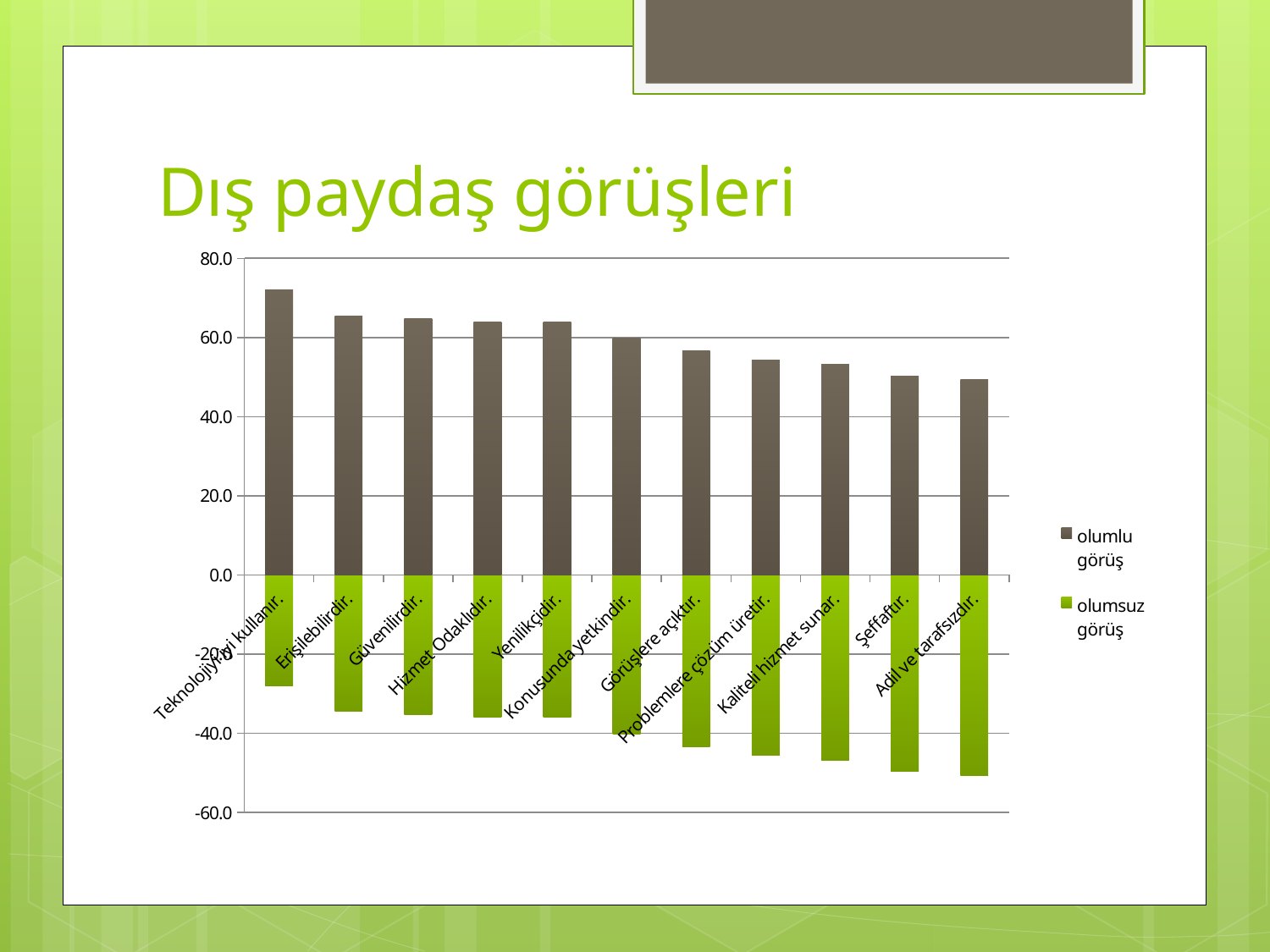
Is the olumsuz görüş value for Adil ve tarafsızdır greater or less than -40? less Is the olumlu görüş value for Adil ve tarafsızdır greater or less than 60? less What kind of chart is shown on the slide? Bar chart Which category has the lowest olumlu görüş value? Adil ve tarafsızdır. Is the olumlu görüş value for Teknolojiyi iyi kullanır greater or less than 60? greater Which category has the highest olumlu görüş value? Teknolojiyi iyi kullanır. How many series does the chart's legend list? 2 What is the title of the slide containing the chart? Dış paydaş görüşleri Which has the larger olumlu görüş value, Erişilebilirdir or Şeffaftır? Erişilebilirdir. Do the olumlu görüş values rise or fall from left to right along the x axis? fall How many categories are plotted along the x axis of the chart? 11 Which series is shown in green in the chart? olumsuz görüş